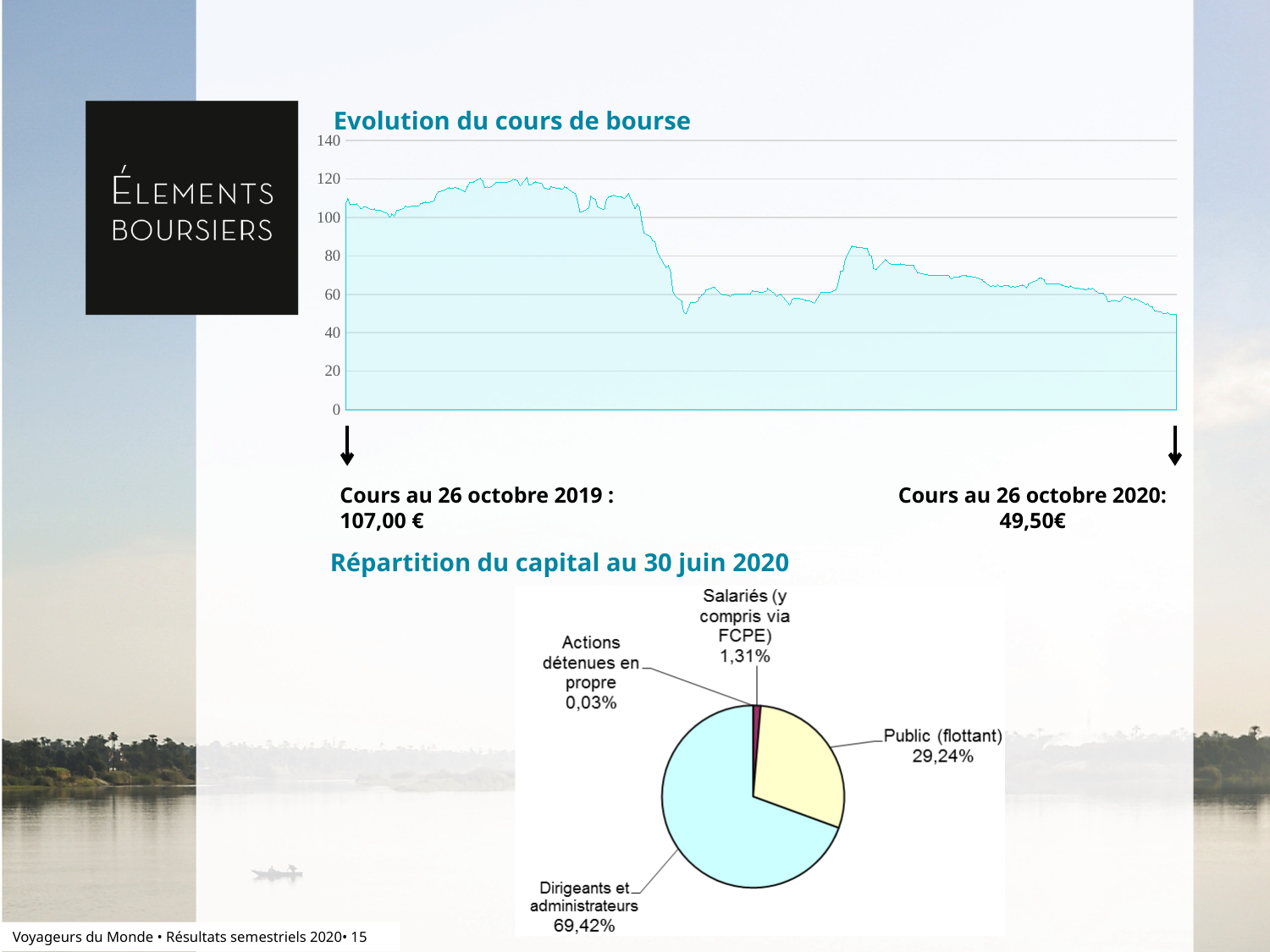
In the 'Répartition du capital au 30 juin 2020' chart, what share of the capital is held by Public (flottant)? 29,24% In the 'Evolution du cours de bourse' chart, what was the share price on 26 octobre 2019? 107,00 € In the 'Répartition du capital au 30 juin 2020' chart, which category holds the largest share of the capital? Dirigeants et administrateurs In the 'Evolution du cours de bourse' chart, does the share price overall rise or fall from left to right? fall In the 'Répartition du capital au 30 juin 2020' chart, what is the difference between the shares of Dirigeants et administrateurs and Public (flottant)? 40,18% How many slices does the 'Répartition du capital au 30 juin 2020' pie chart have? 4 In the 'Evolution du cours de bourse' chart, what was the share price on 26 octobre 2020? 49,50€ In the 'Evolution du cours de bourse' chart, is the highest value reached by the share price greater or less than 100? greater In the 'Répartition du capital au 30 juin 2020' chart, which category holds the smallest share of the capital? Actions détenues en propre What kind of chart is the 'Répartition du capital au 30 juin 2020' chart? pie chart What kind of chart is the 'Evolution du cours de bourse' chart? area chart In the 'Evolution du cours de bourse' chart, by how much did the share price fall between 26 octobre 2019 and 26 octobre 2020? 57,50 €